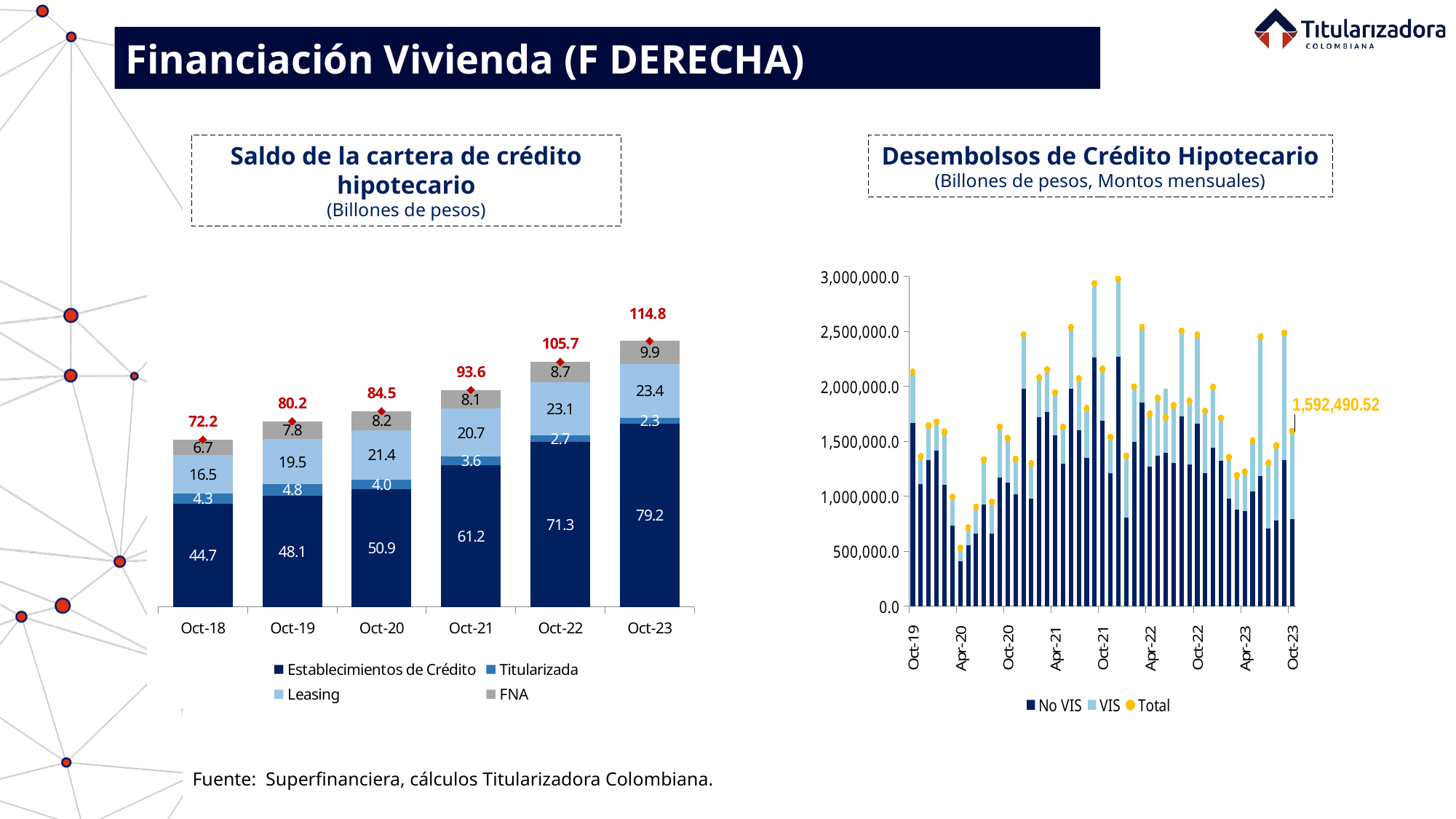
How many series does the legend of the 'Saldo de la cartera de crédito hipotecario' chart list? 4 How many years are shown on the x axis of the 'Saldo de la cartera de crédito hipotecario' chart? 6 In the 'Saldo de la cartera de crédito hipotecario' chart, what is the difference between the Oct-23 total and the Oct-22 total? 9.1 In the 'Saldo de la cartera de crédito hipotecario' chart, what is the total shown above the Oct-21 bar? 93.6 In the 'Saldo de la cartera de crédito hipotecario' chart, do the totals rise or fall from Oct-18 to Oct-23? rise In the 'Saldo de la cartera de crédito hipotecario' chart, which year has the highest total? Oct-23 In the 'Desembolsos de Crédito Hipotecario' chart, what is the Total value labeled for Oct-23? 1,592,490.52 In the 'Saldo de la cartera de crédito hipotecario' chart, is the FNA value larger in Oct-19 or Oct-20? Oct-20 What kind of chart is the 'Desembolsos de Crédito Hipotecario' chart? stacked bar chart In the 'Saldo de la cartera de crédito hipotecario' chart, which year has the lowest Titularizada value? Oct-23 In the 'Saldo de la cartera de crédito hipotecario' chart, what is the Leasing value for Oct-20? 21.4 In the 'Saldo de la cartera de crédito hipotecario' chart, what is the value for Establecimientos de Crédito in Oct-23? 79.2